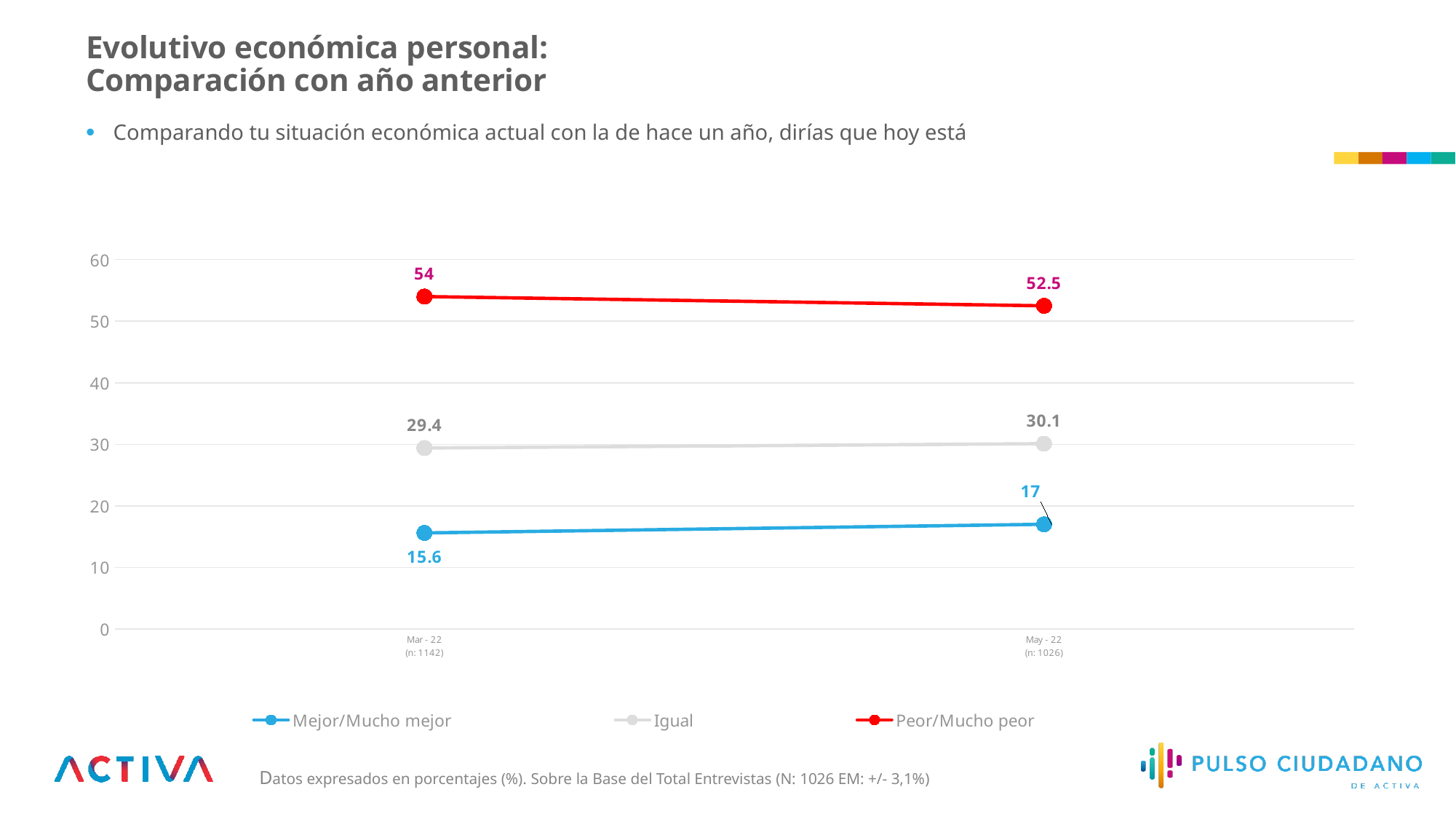
Which series has the lowest value in Mar - 22? Mejor/Mucho mejor What kind of chart is shown on the slide? Line chart How many time points are plotted on the x axis? 2 What is the value for Peor/Mucho peor in May - 22? 52.5 What is the value for Igual in Mar - 22? 29.4 What is the value for Mejor/Mucho mejor in May - 22? 17 Which is larger: Igual in Mar - 22 or Igual in May - 22? Igual in May - 22 How many series does the legend list? 3 What is the difference between the Peor/Mucho peor values in Mar - 22 and May - 22? 1.5 What is the value for Peor/Mucho peor in Mar - 22? 54 Does the Mejor/Mucho mejor series rise or fall from Mar - 22 to May - 22? Rise Which series has the highest value in May - 22? Peor/Mucho peor